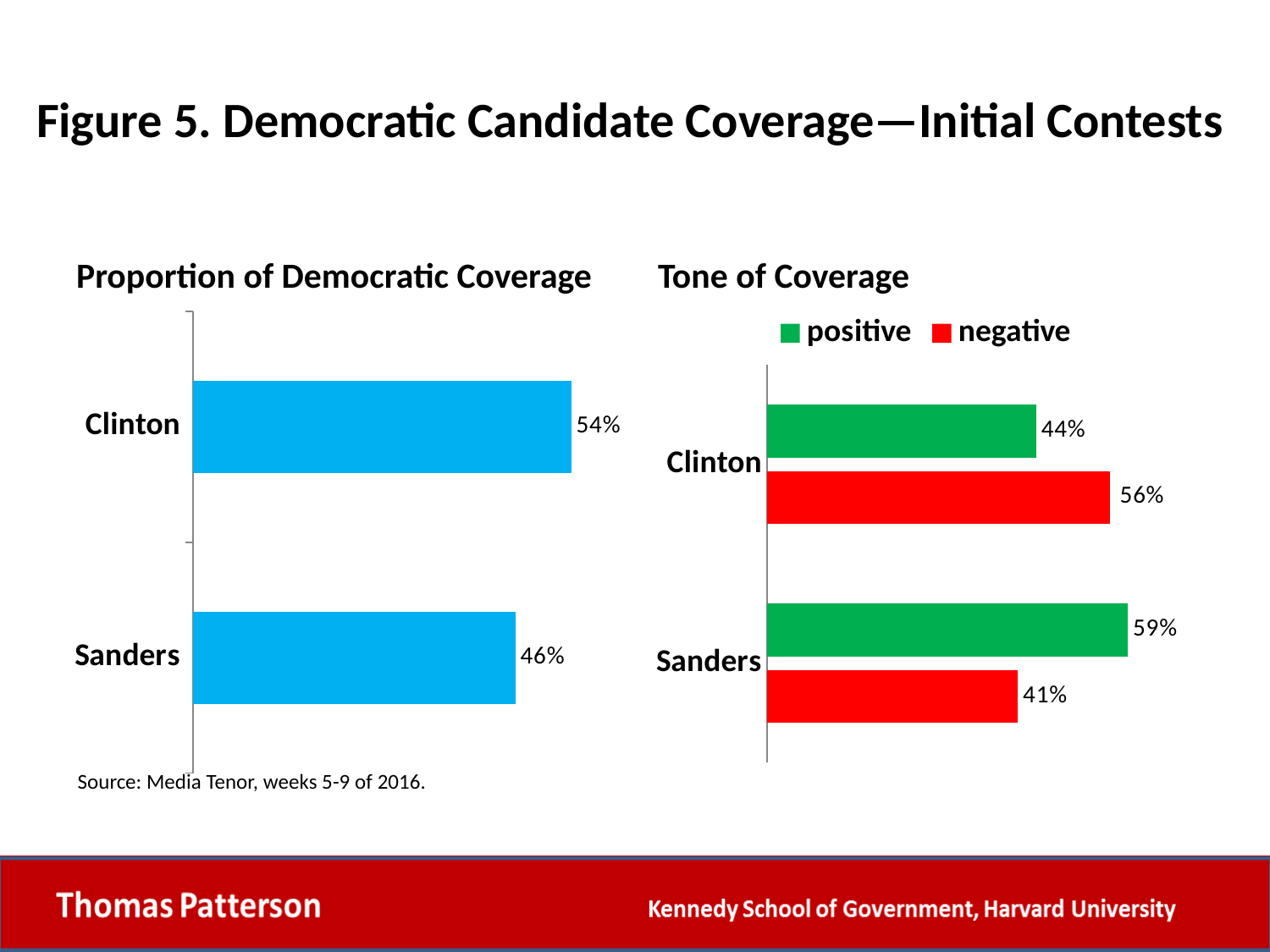
In the 'Tone of Coverage' chart, what is the difference between Sanders' positive and negative values? 18% In the 'Proportion of Democratic Coverage' chart, what is the value for Sanders? 46% In the 'Proportion of Democratic Coverage' chart, what is the difference between Clinton's and Sanders' values? 8% What kind of chart is the 'Proportion of Democratic Coverage' chart? Bar chart In the 'Proportion of Democratic Coverage' chart, what is the value for Clinton? 54% In the 'Tone of Coverage' chart, which candidate has the higher positive value? Sanders In the 'Tone of Coverage' chart, what is the positive value for Clinton? 44% In the 'Proportion of Democratic Coverage' chart, which candidate has the higher proportion of coverage? Clinton How many series does the legend of the 'Tone of Coverage' chart list? 2 In the 'Tone of Coverage' chart, what is the negative value for Sanders? 41% In the 'Tone of Coverage' chart, what is the negative value for Clinton? 56% In the 'Tone of Coverage' chart, what colour represents the negative series? Red